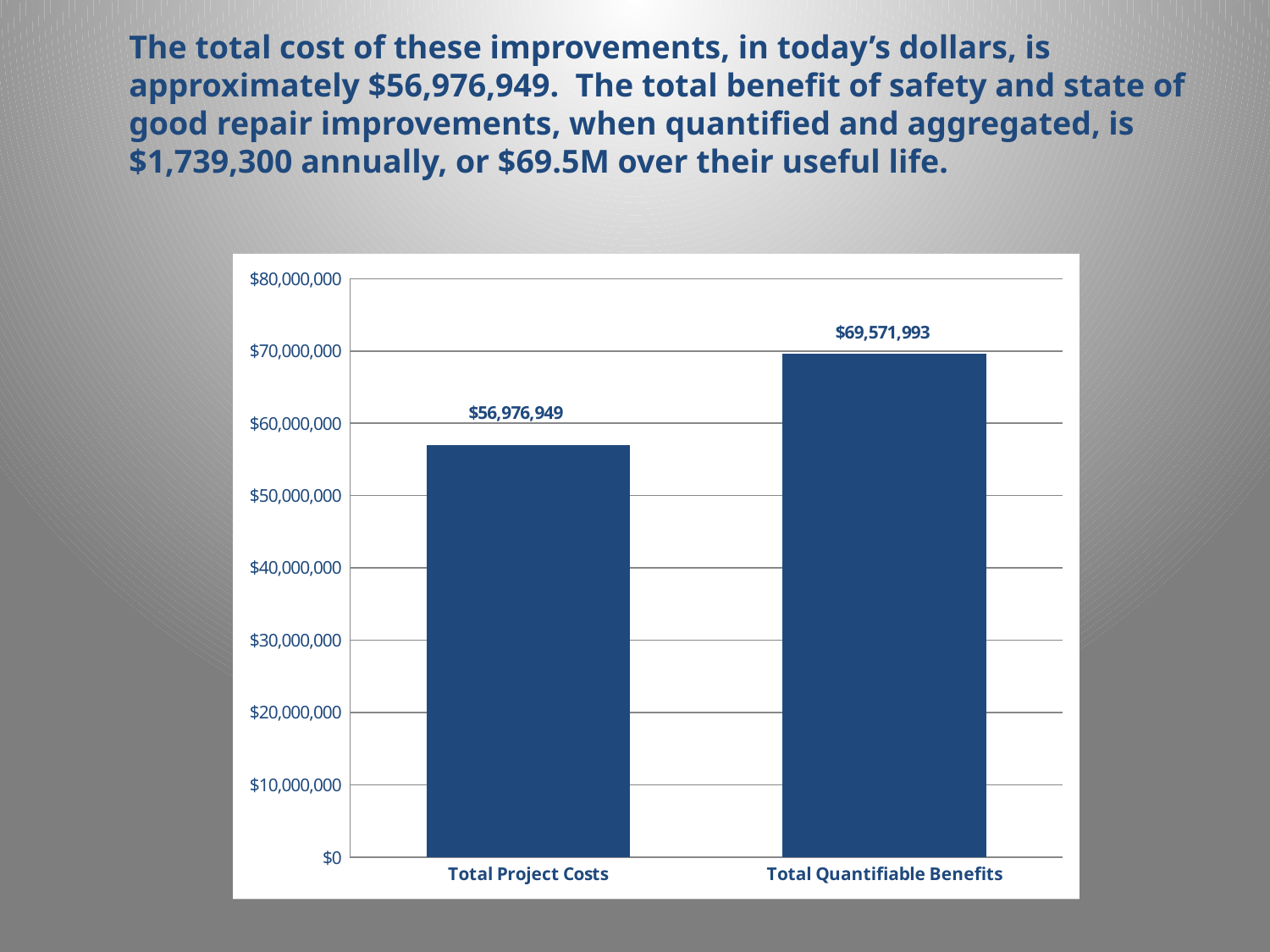
What kind of chart is shown on the slide? bar chart Is the value for Total Project Costs larger or smaller than the value for Total Quantifiable Benefits? smaller What is the difference between Total Quantifiable Benefits and Total Project Costs? $12,595,044 How many categories are shown on the chart? 2 What is the highest value shown on the vertical axis? $80,000,000 What is the value for Total Quantifiable Benefits? $69,571,993 What is the value for Total Project Costs? $56,976,949 Which category has the higher value? Total Quantifiable Benefits Which category has the lower value? Total Project Costs Is the value for Total Quantifiable Benefits greater or less than $60,000,000? greater Is the value for Total Project Costs greater or less than $60,000,000? less What is the label of the first bar on the chart? Total Project Costs